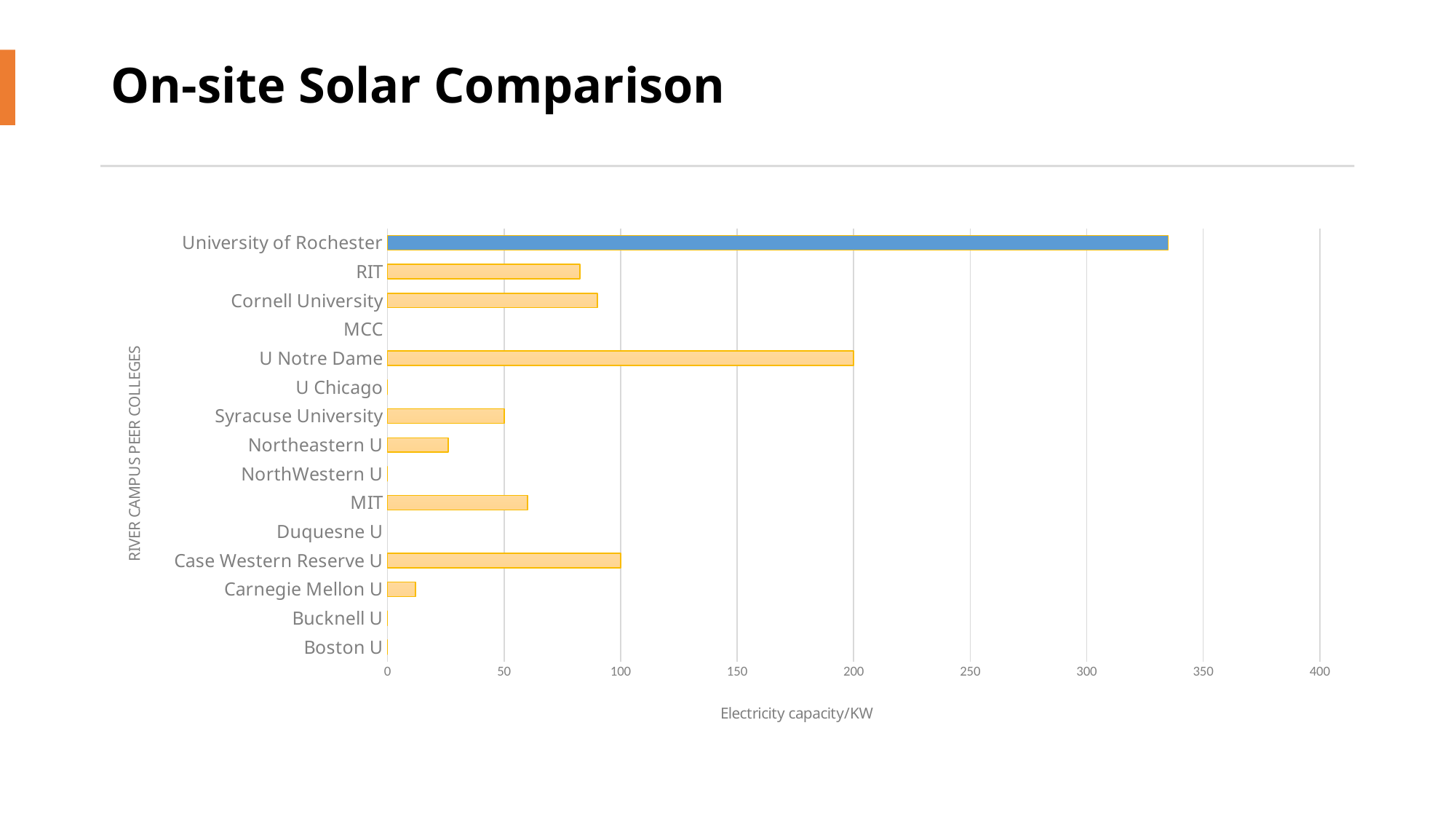
What is the title of the x axis of the chart? Electricity capacity/KW What is the electricity capacity for U Notre Dame? 200 Is the value for University of Rochester greater or less than 300? greater Is the value for RIT greater or less than 100? less Which has a larger electricity capacity, U Notre Dame or Case Western Reserve U? U Notre Dame Is the value for MIT greater or less than 50? greater What is the electricity capacity for Case Western Reserve U? 100 What is the difference in electricity capacity between U Notre Dame and Case Western Reserve U? 100 Which college has the highest electricity capacity in the chart? University of Rochester What is the electricity capacity for Syracuse University? 50 How many colleges are listed on the y axis of the chart? 15 What kind of chart is shown on the slide? bar chart